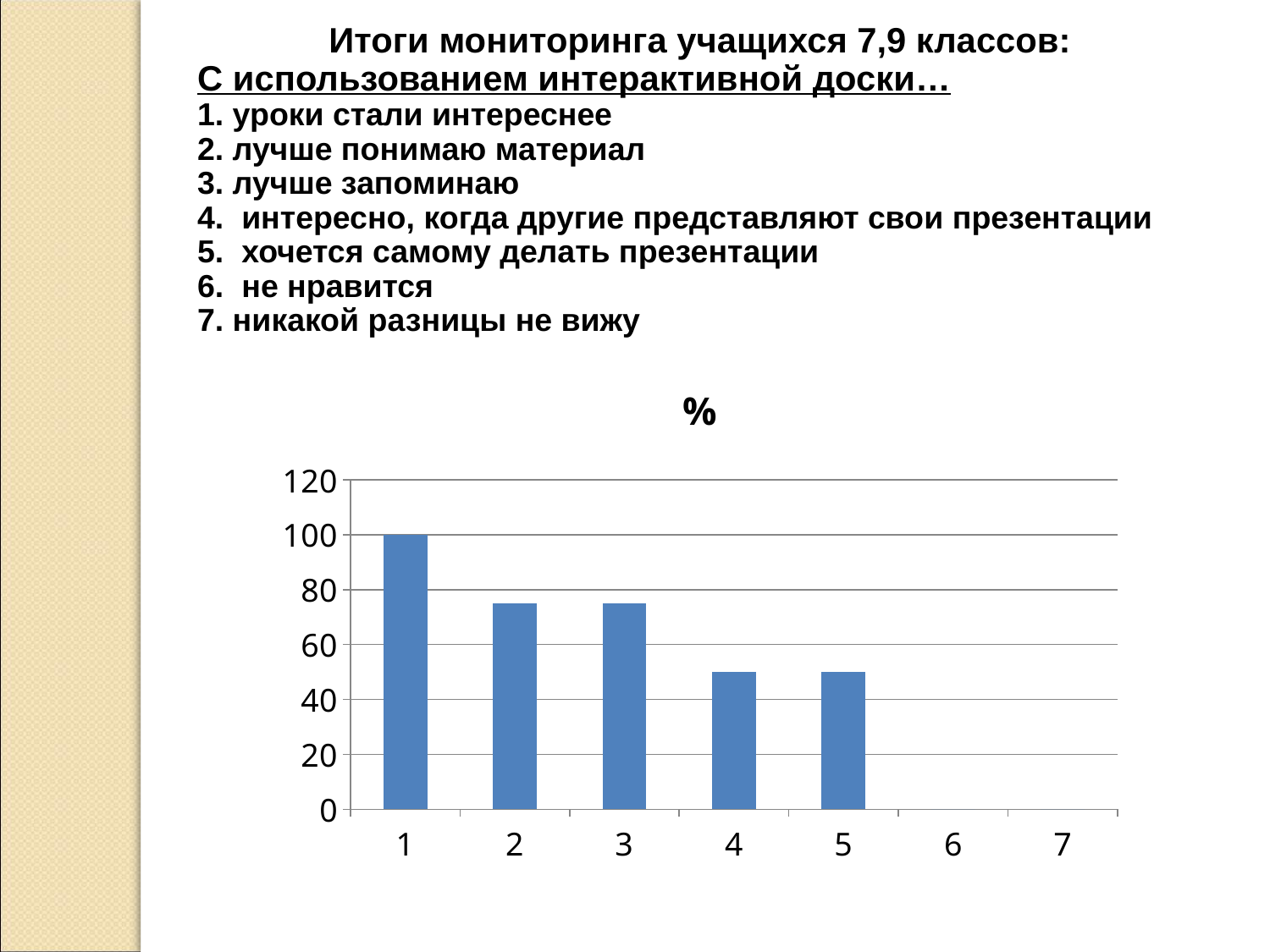
Which category has the highest bar in the chart? 1 Do the bar values generally rise or fall from category 1 to category 7? fall What is the value for category 1 in the chart? 100 Is the value for category 4 greater or less than 40? greater Is the value for category 2 greater or less than 60? greater Which is larger, the value for category 1 or the value for category 4? category 1 Which is larger, the value for category 2 or the value for category 5? category 2 How many categories are shown on the x axis of the chart? 7 What type of chart is shown on the slide? bar chart Is the value for category 5 greater or less than 60? less What is the title of the chart? %